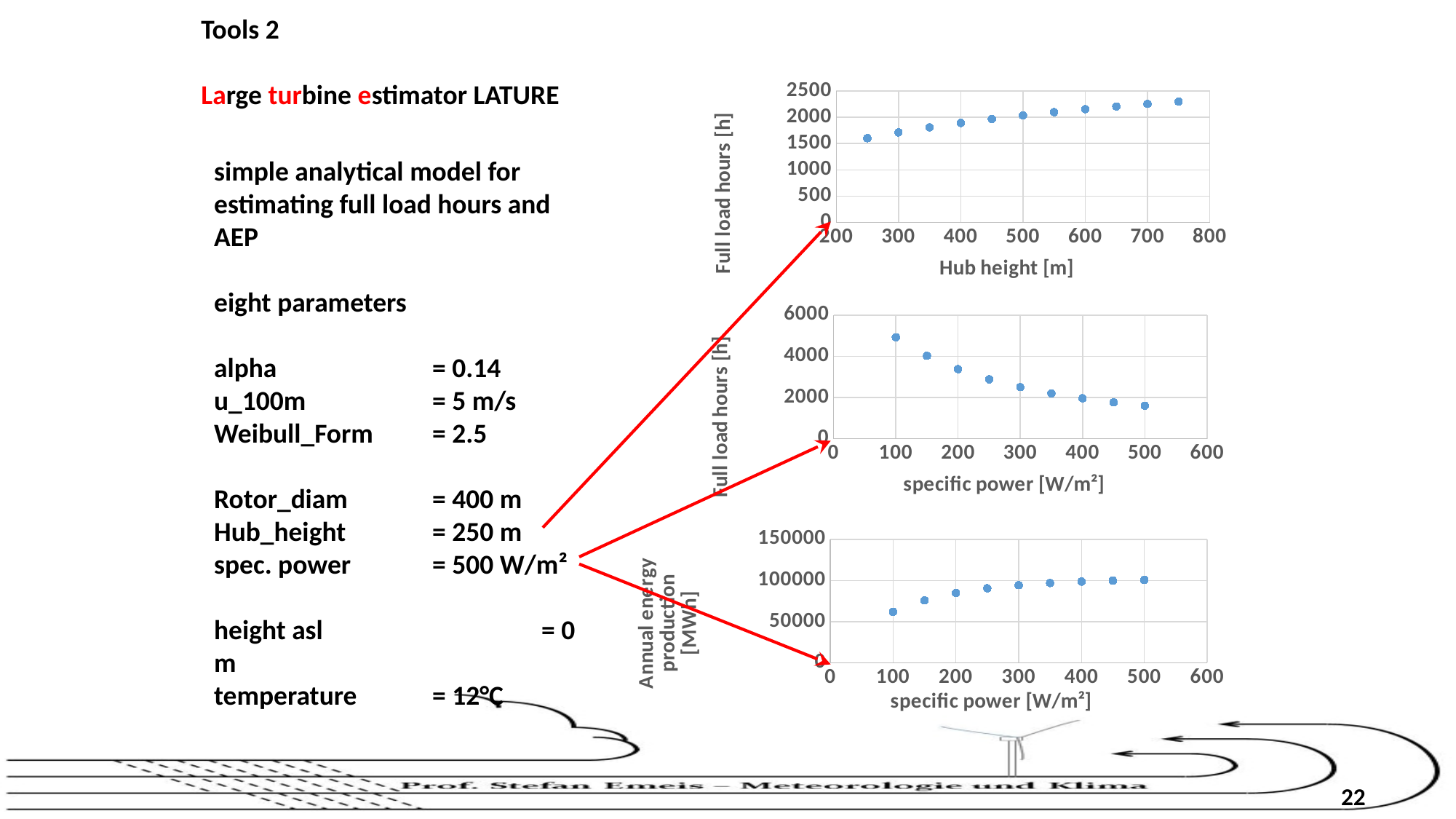
In the middle chart (Full load hours vs specific power), is the value at a specific power of 100 W/m² greater or less than 4000? greater In the top chart (Full load hours vs Hub height), do the full load hours rise or fall as hub height increases? rise What type of chart is the top chart (Full load hours vs Hub height)? scatter chart In the middle chart (Full load hours vs specific power), at which specific power is the full load hours value highest? 100 What is the x-axis label of the bottom chart? specific power [W/m²] In the middle chart (Full load hours vs specific power), how many data points are plotted? 9 In the bottom chart (Annual energy production vs specific power), is the value at a specific power of 100 W/m² greater or less than 50000? greater In the middle chart (Full load hours vs specific power), do the full load hours rise or fall as specific power increases? fall In the bottom chart (Annual energy production vs specific power), do the values rise or fall as specific power increases? rise In the top chart (Full load hours vs Hub height), is the value at a hub height of 250 m greater or less than 1500? greater In the top chart (Full load hours vs Hub height), how many data points are plotted? 11